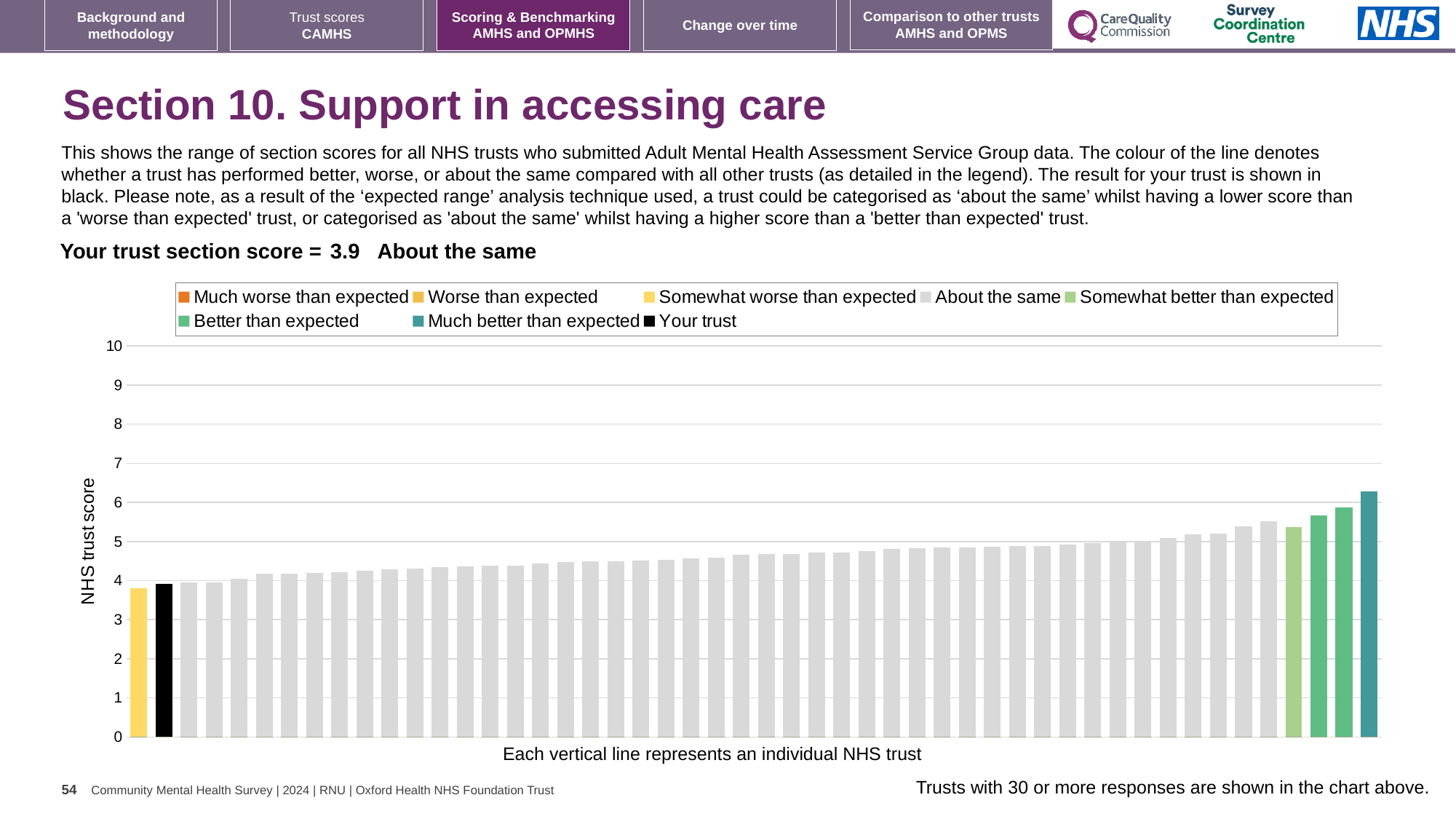
What kind of chart is shown on the slide? bar chart Is the value of the shortest bar in the chart greater or less than 5? less Do the bar values rise or fall from left to right along the x axis? rise Which performance category does 'Your trust' fall into according to the slide? About the same How many bars in the chart are coloured as 'Better than expected'? 2 How many entries does the chart legend list? 8 Which legend category does the tallest bar in the chart belong to? Much better than expected What is the section score for 'Your trust' shown on the slide? 3.9 Which legend category does the shortest bar in the chart belong to? Somewhat worse than expected Is the 'Your trust' bar higher or lower than the 'Much better than expected' bar? lower What is the label on the vertical axis of the chart? NHS trust score Is the value of the tallest bar in the chart greater or less than 6? greater